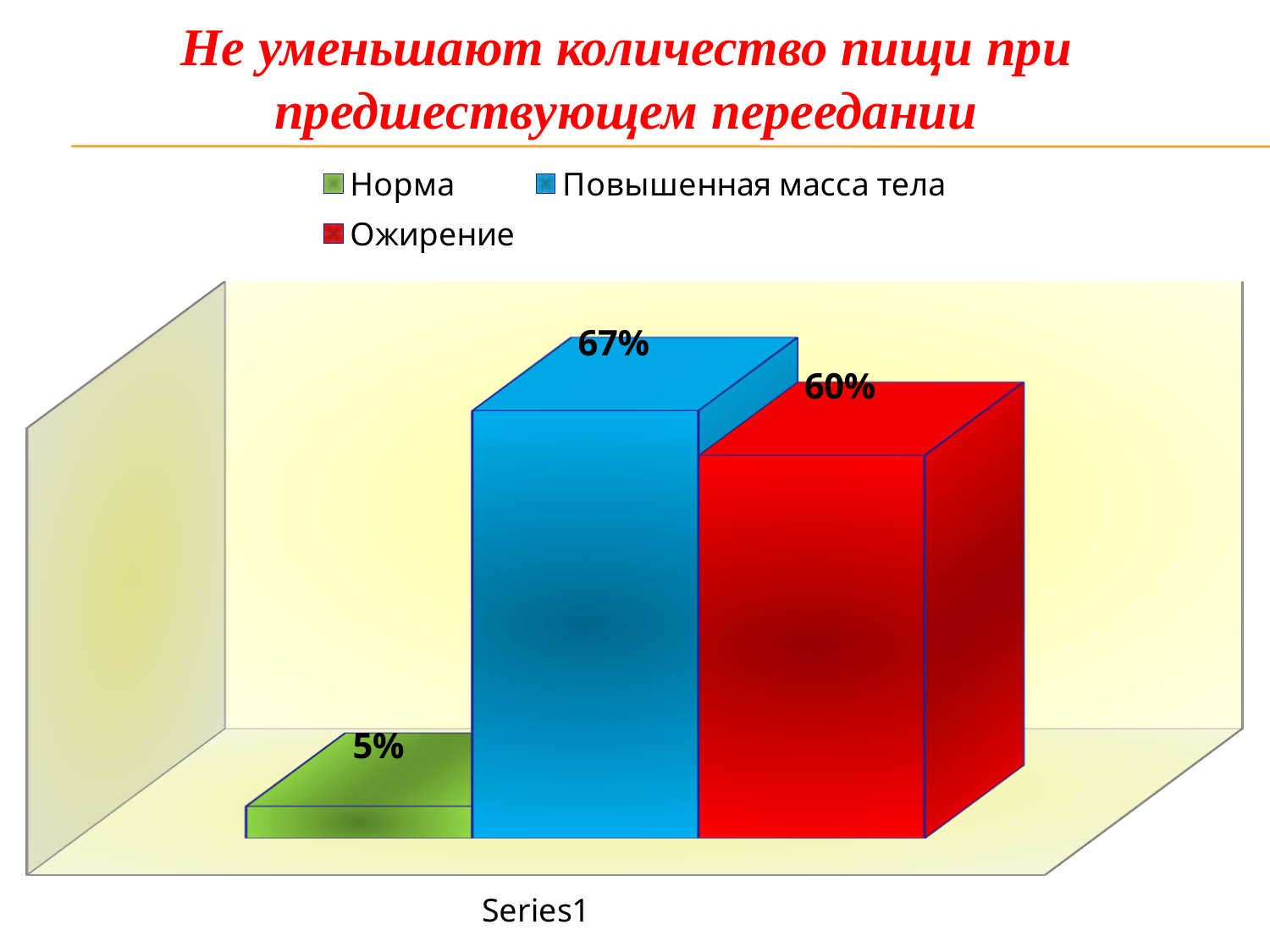
What is the difference between the values for Ожирение and Норма? 55% How many series does the legend list? 3 Which series has the lowest value? Норма What is the title of the chart? Не уменьшают количество пищи при предшествующем переедании What colour is the bar for Ожирение? red What is the value for Ожирение? 60% What is the value for Повышенная масса тела? 67% What kind of chart is shown on the slide? bar chart Which is larger, the value for Повышенная масса тела or the value for Ожирение? Повышенная масса тела Which series has the highest value? Повышенная масса тела What is the value for Норма? 5% What is the difference between the values for Повышенная масса тела and Ожирение? 7%